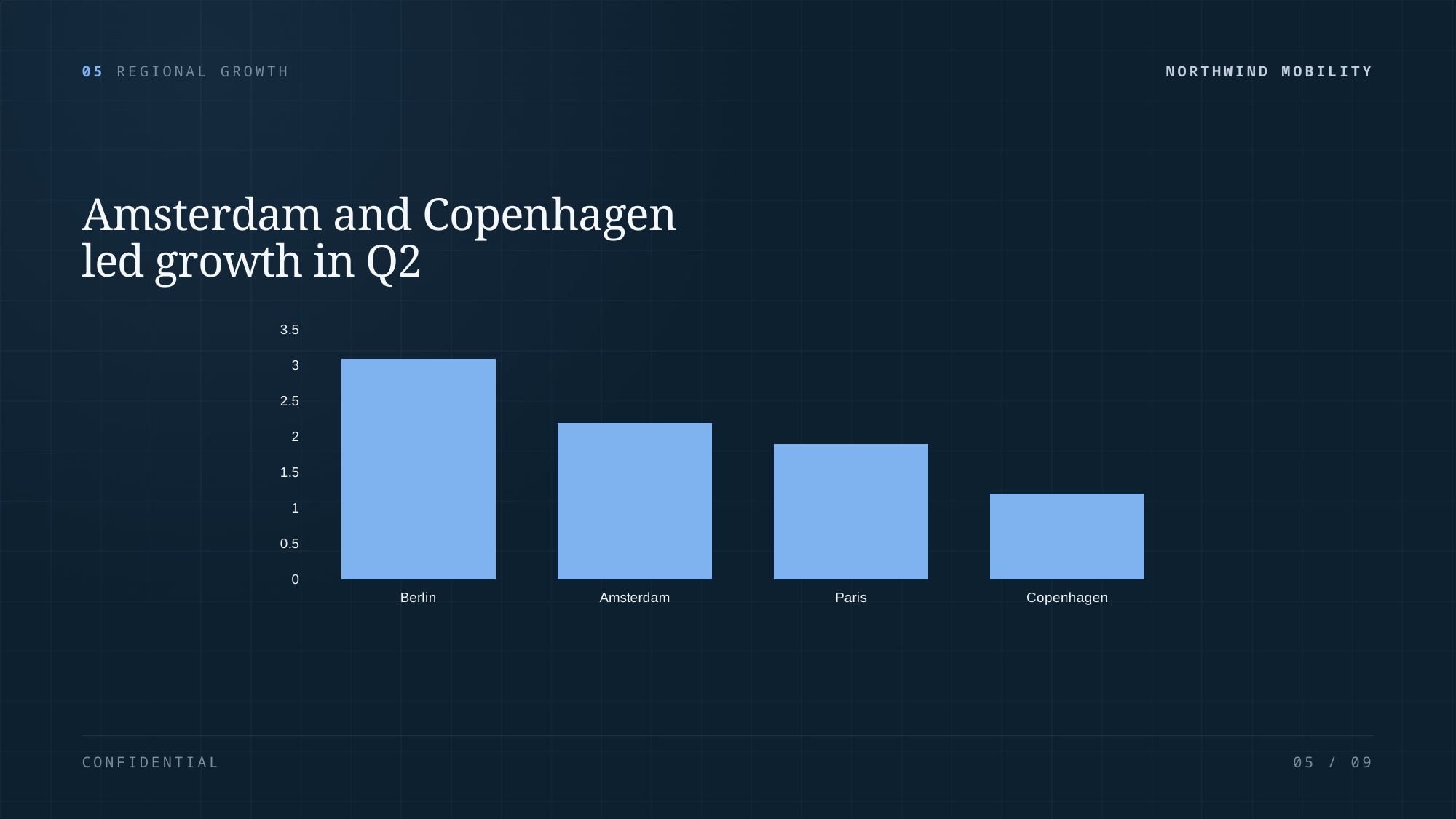
How many cities are shown on the chart? 4 Which city has the lowest bar? Copenhagen Is the value for Amsterdam greater or less than 2? greater Is the value for Paris greater or less than 1.5? greater What kind of chart is shown on the slide? bar chart Which city has the highest bar? Berlin Which is larger, the value for Berlin or the value for Amsterdam? Berlin Which is larger, the value for Amsterdam or the value for Paris? Amsterdam Is the value for Copenhagen greater or less than 1.5? less Do the bar values rise or fall from Berlin to Copenhagen along the x axis? fall What is the title of the slide above the chart? Amsterdam and Copenhagen led growth in Q2